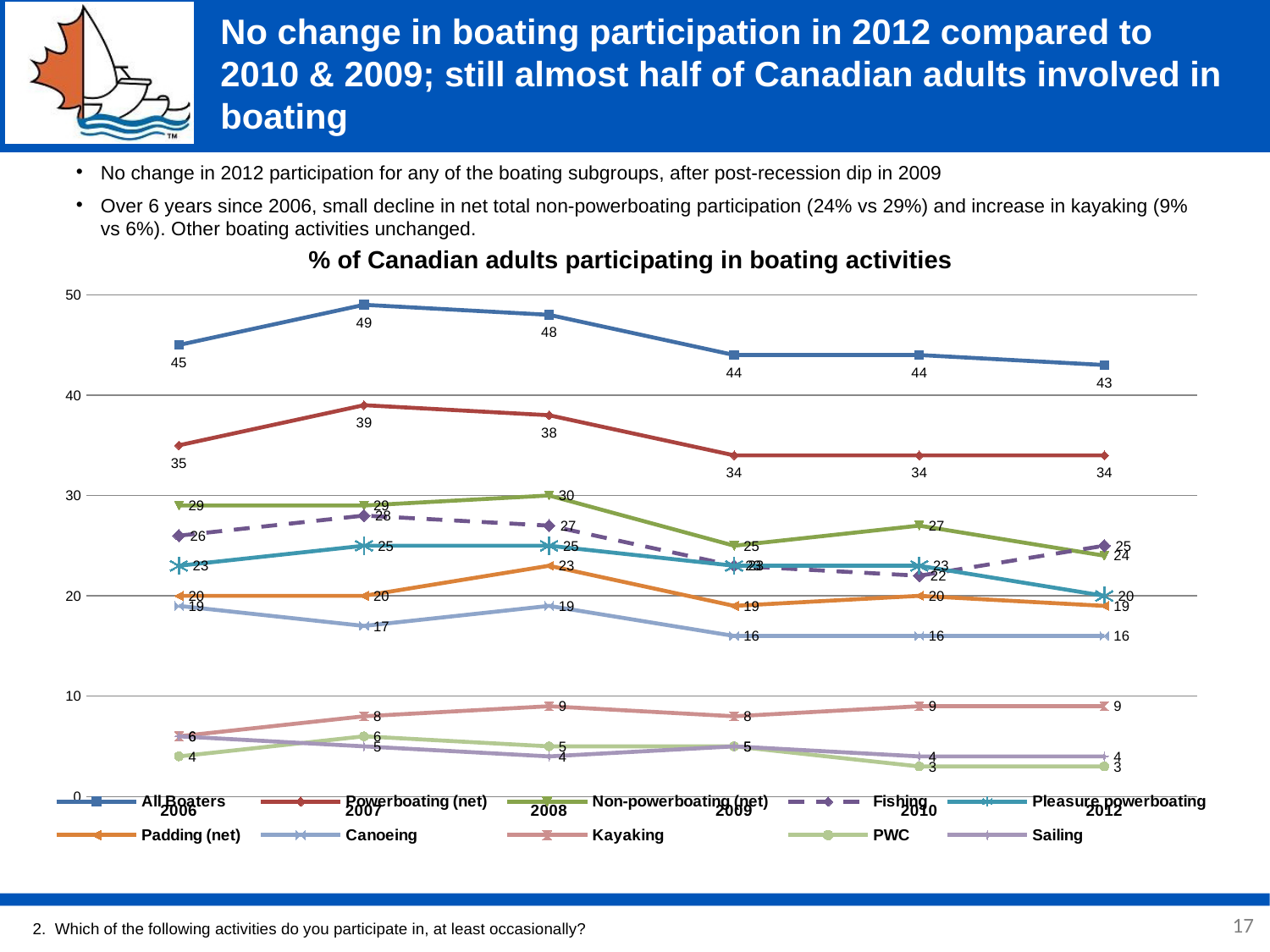
What is the value for Kayaking in 2006? 6 What is the difference between the All Boaters value in 2007 and in 2012? 6 What type of chart is shown on the slide? line chart How many years are plotted along the x axis? 6 How many series does the chart legend list? 10 In which year is the All Boaters value highest? 2007 In which year is the Canoeing value highest? 2006 and 2008 (tied at 19) What is the value for Powerboating (net) in 2012? 34 Which is larger in 2012, Non-powerboating (net) or Fishing? Fishing What is the value for All Boaters in 2007? 49 Does the Kayaking value rise or fall from 2006 to 2012? rise What is the title of the chart? % of Canadian adults participating in boating activities